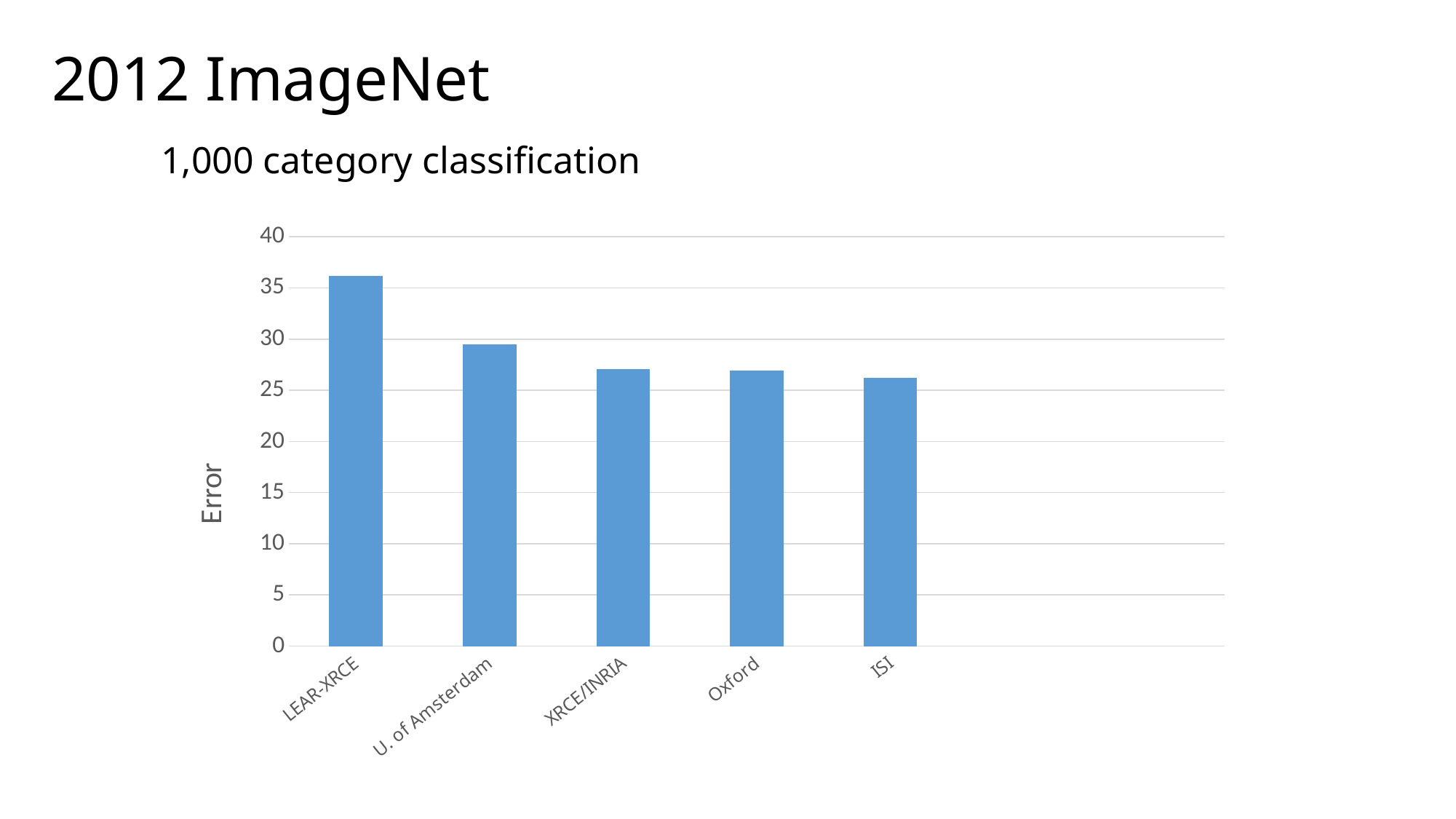
Which has a larger error, U. of Amsterdam or XRCE/INRIA? U. of Amsterdam Which team has the highest error in the chart? LEAR-XRCE Do the error values rise or fall from left to right across the chart? fall Is the error for U. of Amsterdam greater or less than 30? less Is the error for XRCE/INRIA greater or less than 25? greater Is the error for ISI greater or less than 25? greater How many teams (bars) are shown in the chart? 5 What kind of chart is shown on the slide? bar chart What is the label on the vertical axis of the chart? Error Which has a larger error, LEAR-XRCE or ISI? LEAR-XRCE